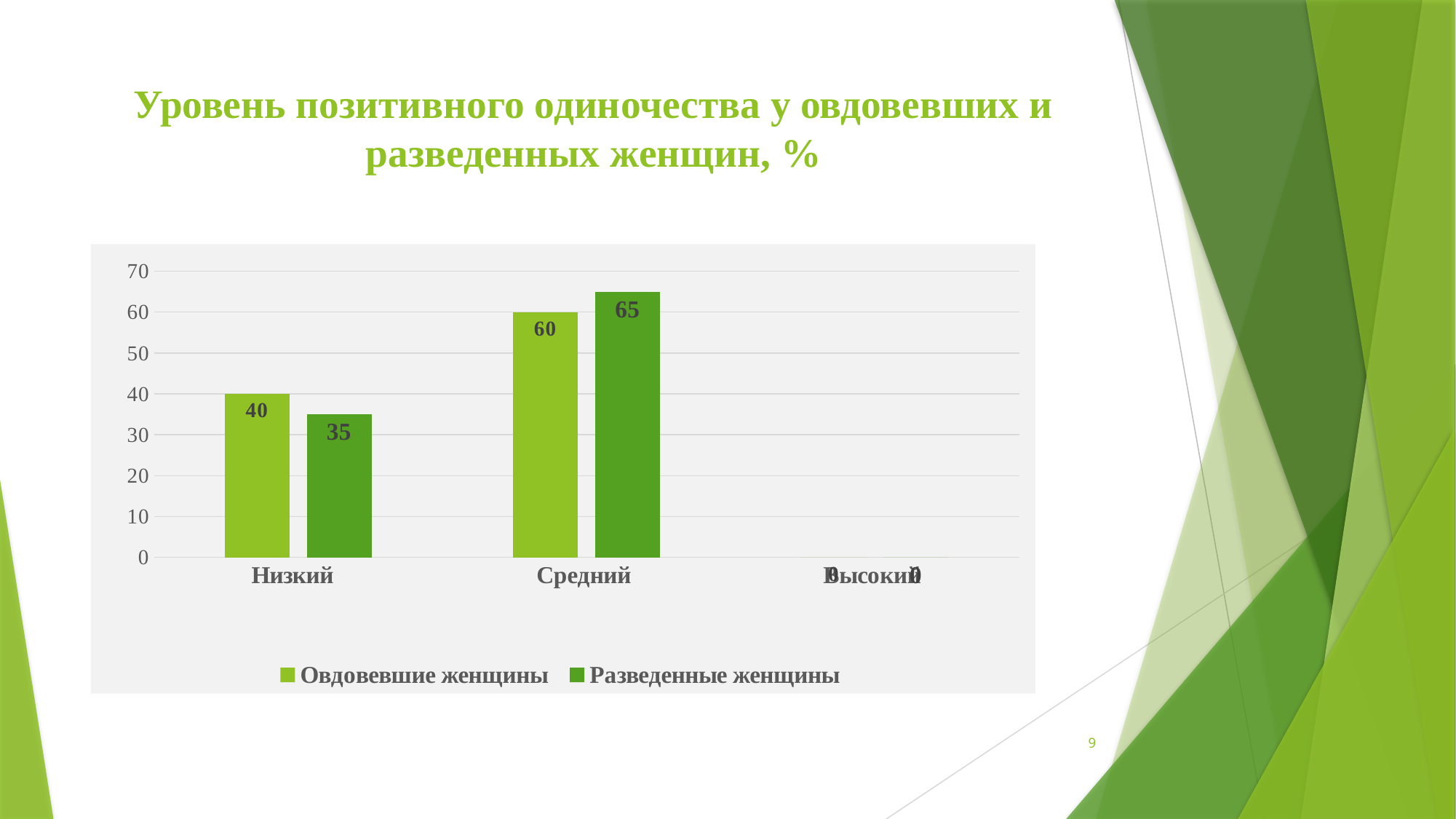
How many categories are shown on the x axis? 3 What is the difference between Овдовевшие женщины and Разведенные женщины in the Низкий category? 5 What is the difference between Разведенные женщины and Овдовевшие женщины in the Средний category? 5 In the Низкий category, which series has the larger value, Овдовевшие женщины or Разведенные женщины? Овдовевшие женщины What is the value for Овдовевшие женщины in the Средний category? 60 What is the title of the slide? Уровень позитивного одиночества у овдовевших и разведенных женщин, % Which category has the highest value for Разведенные женщины? Средний What kind of chart is shown on the slide? Bar chart What is the value for Разведенные женщины in the Средний category? 65 What is the value for Разведенные женщины in the Низкий category? 35 How many series does the legend list? 2 What is the value for Овдовевшие женщины in the Низкий category? 40